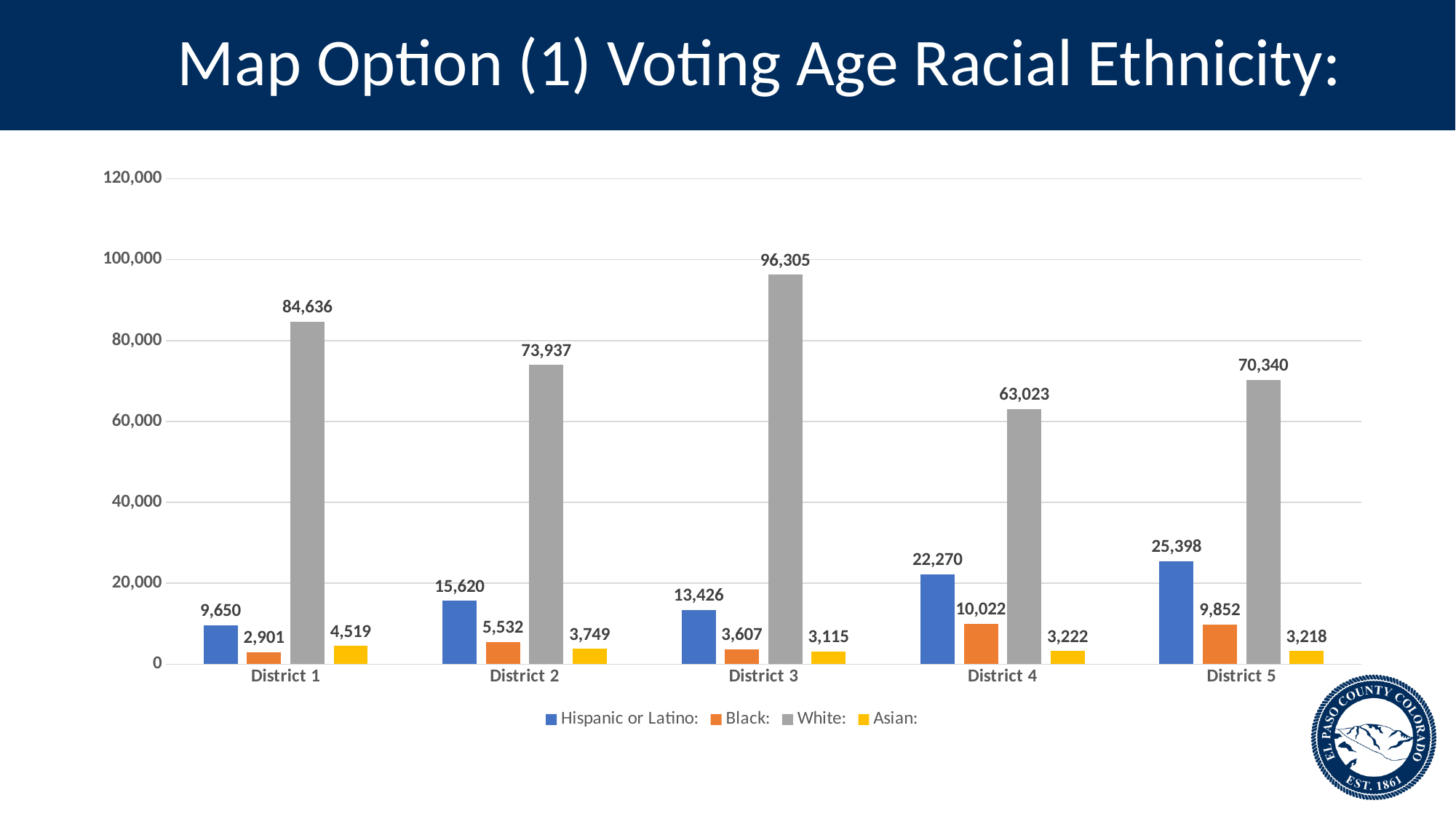
How many series does the legend list? 4 How many districts are shown on the x axis? 5 What is the difference between the White values for District 1 and District 2? 10,699 Is the White value for District 4 greater or less than 60,000? greater What is the White value for District 3? 96,305 What is the Hispanic or Latino value for District 5? 25,398 What is the Asian value for District 1? 4,519 Which is larger, the Black value for District 2 or the Black value for District 3? District 2 What kind of chart is shown on the slide? bar chart Which district has the highest White value? District 3 Which district has the lowest Hispanic or Latino value? District 1 What is the Black value for District 4? 10,022